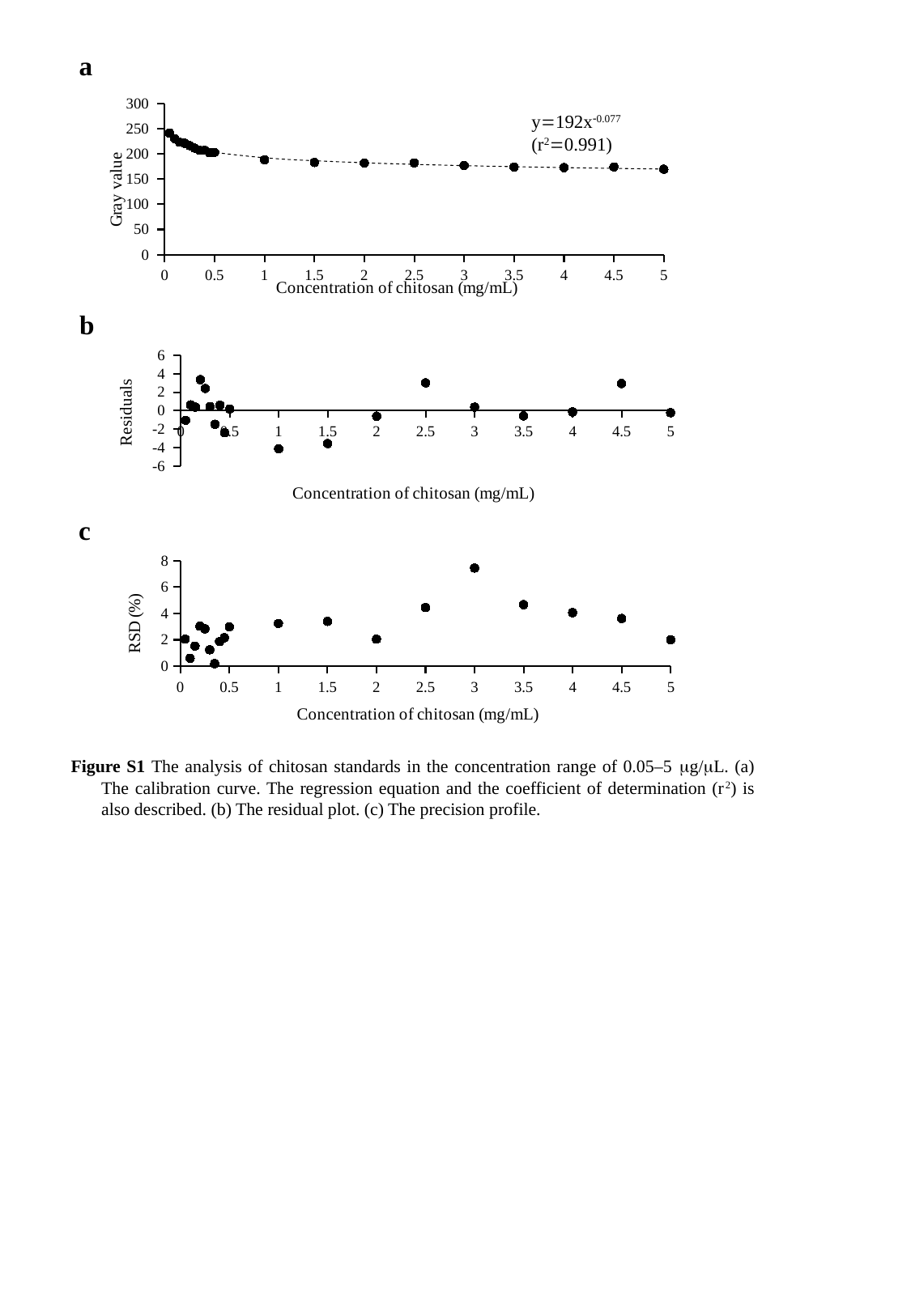
In chart c (bottom), at which concentration of chitosan is the RSD (%) highest? 3 mg/mL In chart b (middle), is the residual at 1 mg/mL greater or less than -2? less In chart a (top), do the gray values rise or fall as the concentration of chitosan increases? fall In chart c (bottom), which is larger, the RSD (%) at 3 mg/mL or at 2 mg/mL? 3 mg/mL In chart a (top), is the gray value at 5 mg/mL greater or less than 200? less In chart a (top), is the gray value at the lowest concentration (near 0 mg/mL) greater or less than 200? greater In chart a (top), what coefficient of determination (r²) is printed on the chart? 0.991 In chart a (top), what regression equation is printed on the chart? y=192x^-0.077 In chart a (top), what kind of chart is used to show gray value against concentration of chitosan? scatter chart